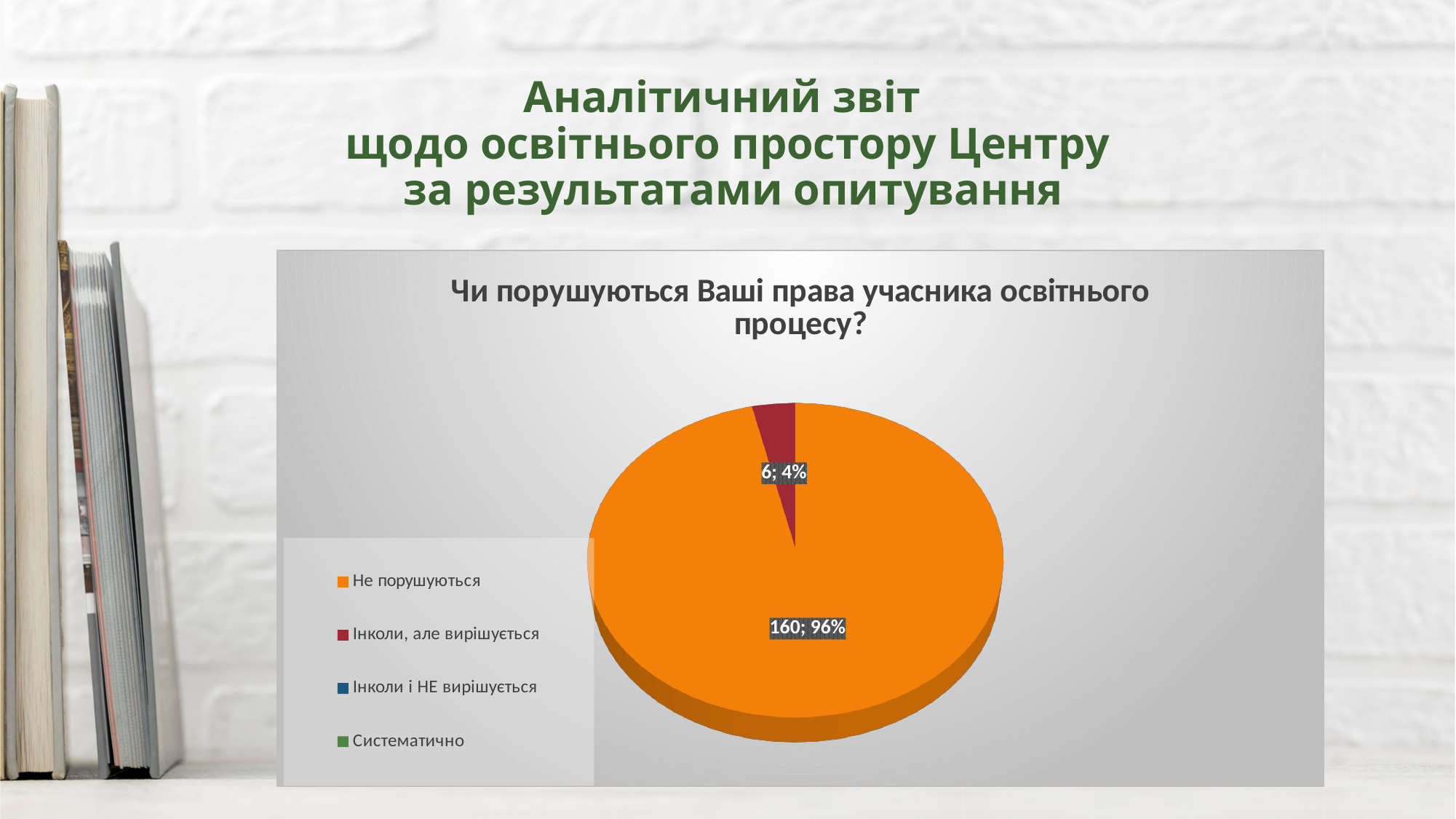
What is the total of the two labelled slices in the pie? 166 What colour is the "Не порушуються" slice? Orange How many entries does the chart legend list? 4 Which is larger: the count for "Не порушуються" or for "Інколи, але вирішується"? Не порушуються What percentage share does the "Інколи, але вирішується" slice have? 4% Which category has the largest slice of the pie? Не порушуються What kind of chart is shown on the slide? Pie chart What percentage share does the "Не порушуються" slice have? 96% What is the title of the chart? Чи порушуються Ваші права учасника освітнього процесу? What is the count shown for the "Не порушуються" slice? 160 What is the count shown for the "Інколи, але вирішується" slice? 6 What is the difference in count between "Не порушуються" and "Інколи, але вирішується"? 154